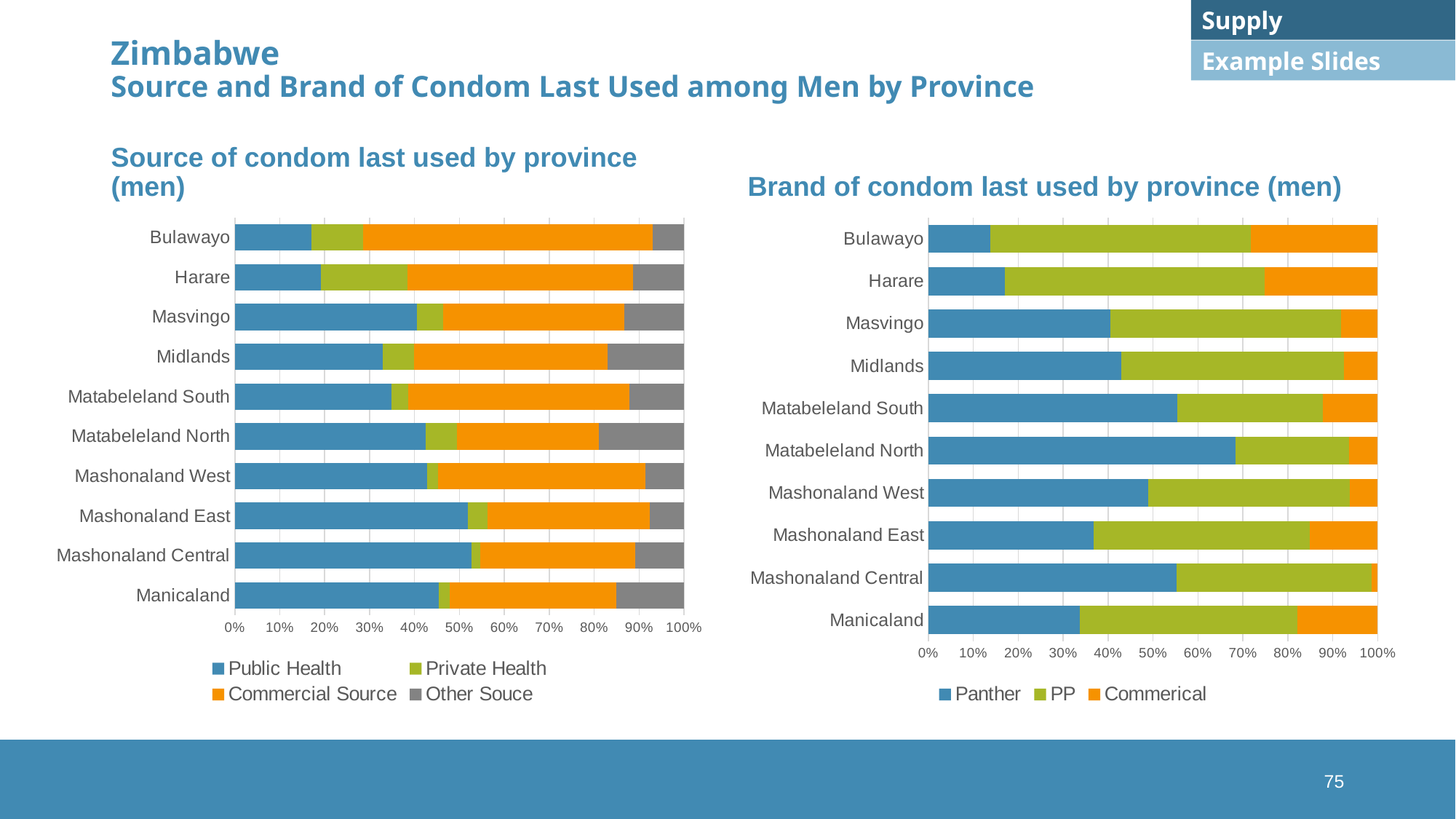
How many provinces are shown in the 'Brand of condom last used by province (men)' chart? 10 In the 'Brand of condom last used by province (men)' chart, which has the larger Commerical share: Bulawayo or Mashonaland Central? Bulawayo In the 'Brand of condom last used by province (men)' chart, which has the larger Panther share: Matabeleland North or Manicaland? Matabeleland North How many series does the legend of the 'Source of condom last used by province (men)' chart list? 4 Which colour represents Commercial Source in the 'Source of condom last used by province (men)' chart? Orange In the 'Source of condom last used by province (men)' chart, is the Public Health share for Masvingo greater or less than 30%? greater How many series does the legend of the 'Brand of condom last used by province (men)' chart list? 3 In the 'Brand of condom last used by province (men)' chart, is the Panther share for Matabeleland North greater or less than 60%? greater What kind of chart is the 'Source of condom last used by province (men)' chart? Stacked bar chart In the 'Brand of condom last used by province (men)' chart, which province has the largest Panther share? Matabeleland North In the 'Source of condom last used by province (men)' chart, is the Public Health share for Bulawayo greater or less than 20%? less